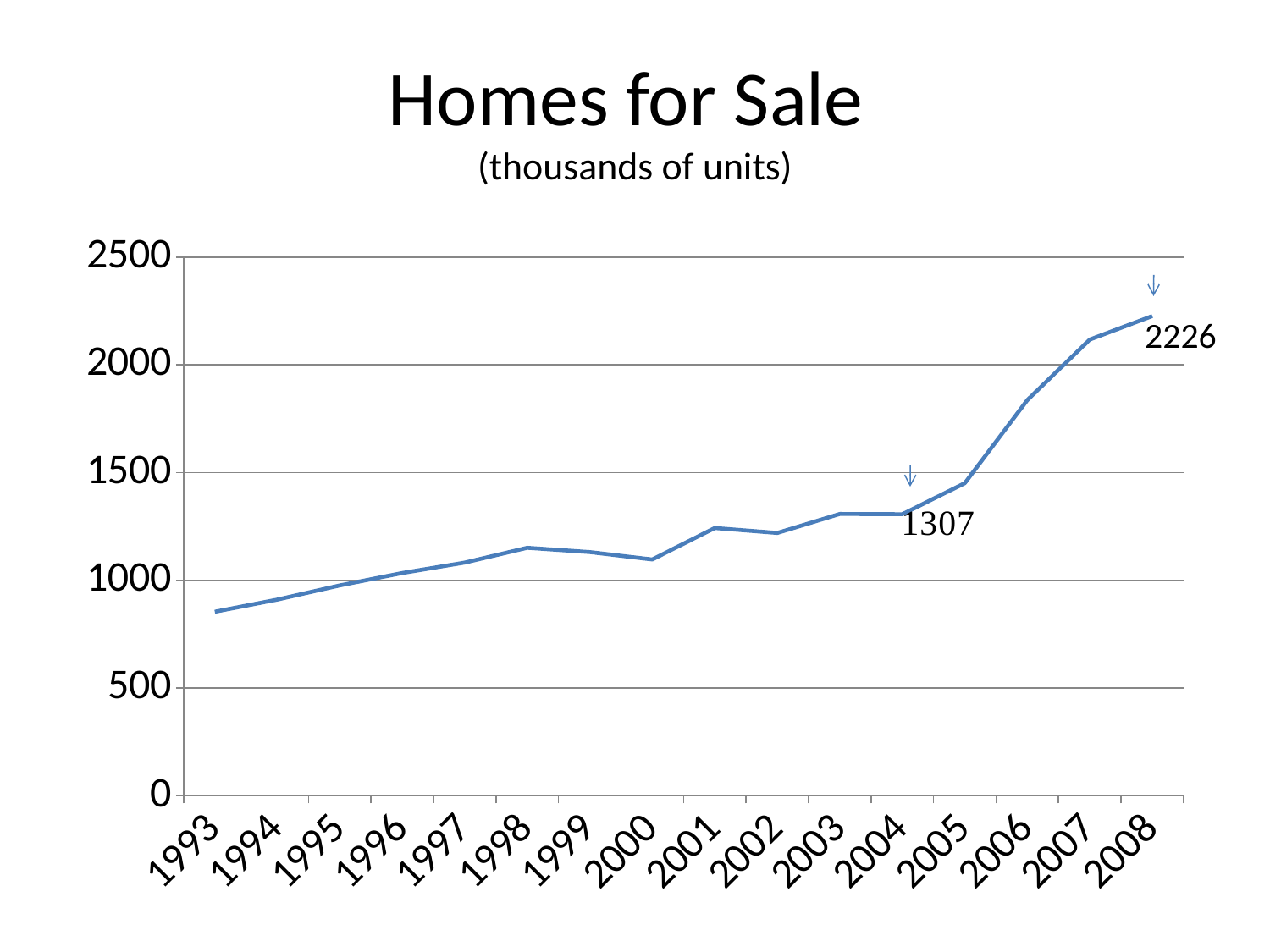
What is the value for 2004? 1307 What kind of chart is shown? Line chart Which year has the highest value? 2008 What is the value for 2008? 2226 In what units are the values shown, according to the subtitle? Thousands of units Do the values generally rise or fall from 1993 to 2008? Rise What is the difference between the values for 2008 and 2004? 919 Which is larger, the value for 2005 or the value for 2003? 2005 Is the value for 2007 greater or less than 2000? greater Which year has the lowest value? 1993 Is the value for 1993 greater or less than 1000? less How many years are plotted on the x axis? 16